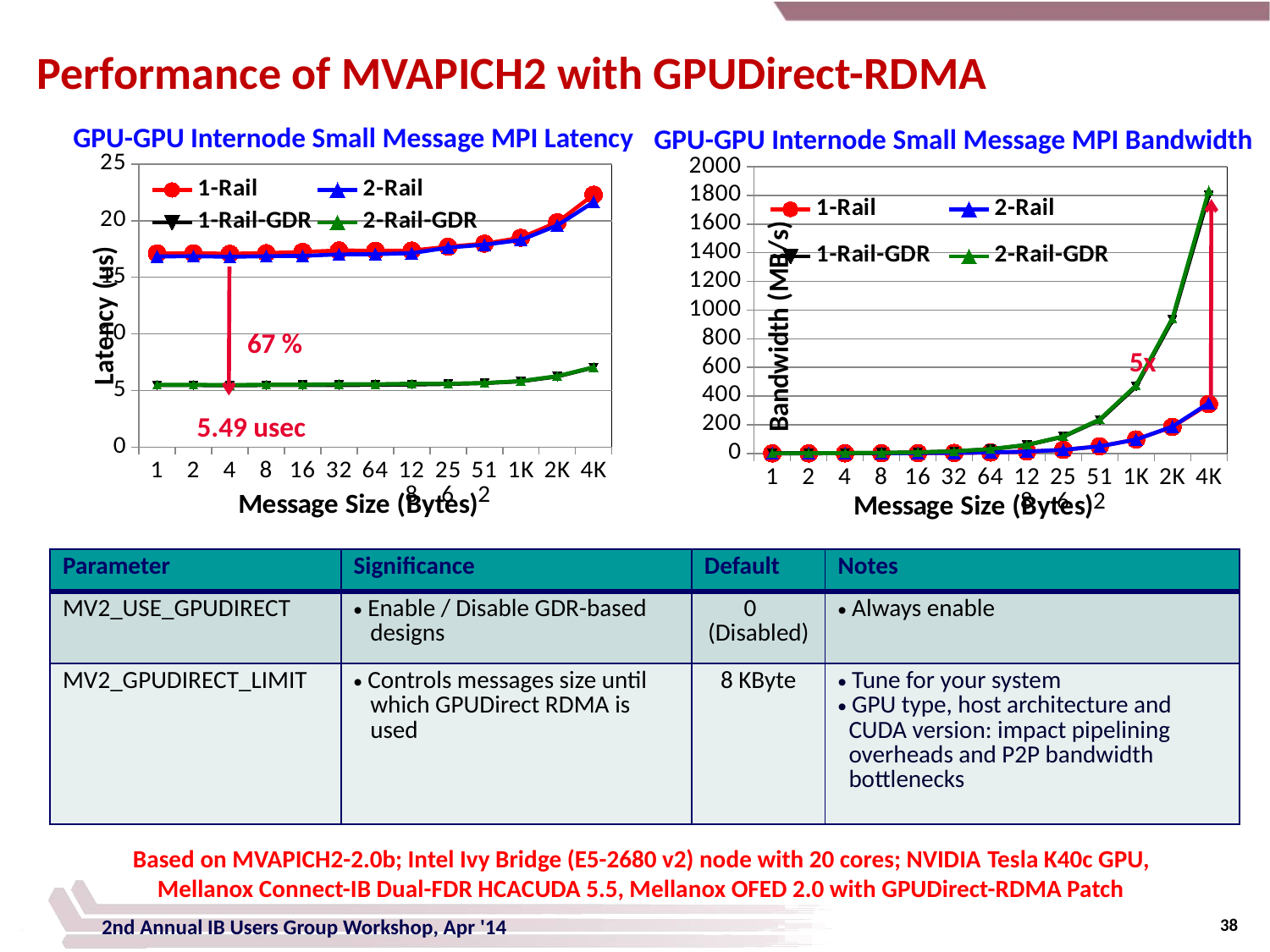
In the GPU-GPU Internode Small Message MPI Latency chart, is the 1-Rail-GDR latency at message size 4 greater or less than 10? less In the GPU-GPU Internode Small Message MPI Bandwidth chart, is the 1-Rail bandwidth at message size 4K greater or less than 400? less In the GPU-GPU Internode Small Message MPI Latency chart, which has the higher latency at message size 4K: 1-Rail or 1-Rail-GDR? 1-Rail In the GPU-GPU Internode Small Message MPI Bandwidth chart, does the 2-Rail-GDR bandwidth rise or fall as message size increases? rise What is the y-axis label of the GPU-GPU Internode Small Message MPI Bandwidth chart? Bandwidth (MB/s) What latency value is annotated on the GPU-GPU Internode Small Message MPI Latency chart? 5.49 usec How many message sizes are shown on the x axis of the GPU-GPU Internode Small Message MPI Latency chart? 13 What kind of chart is the GPU-GPU Internode Small Message MPI Latency chart? line chart In the GPU-GPU Internode Small Message MPI Latency chart, is the 1-Rail latency at message size 4 greater or less than 15? greater How many series does the legend of the GPU-GPU Internode Small Message MPI Bandwidth chart list? 4 In the GPU-GPU Internode Small Message MPI Bandwidth chart, which series reaches the highest bandwidth at message size 4K? 2-Rail-GDR